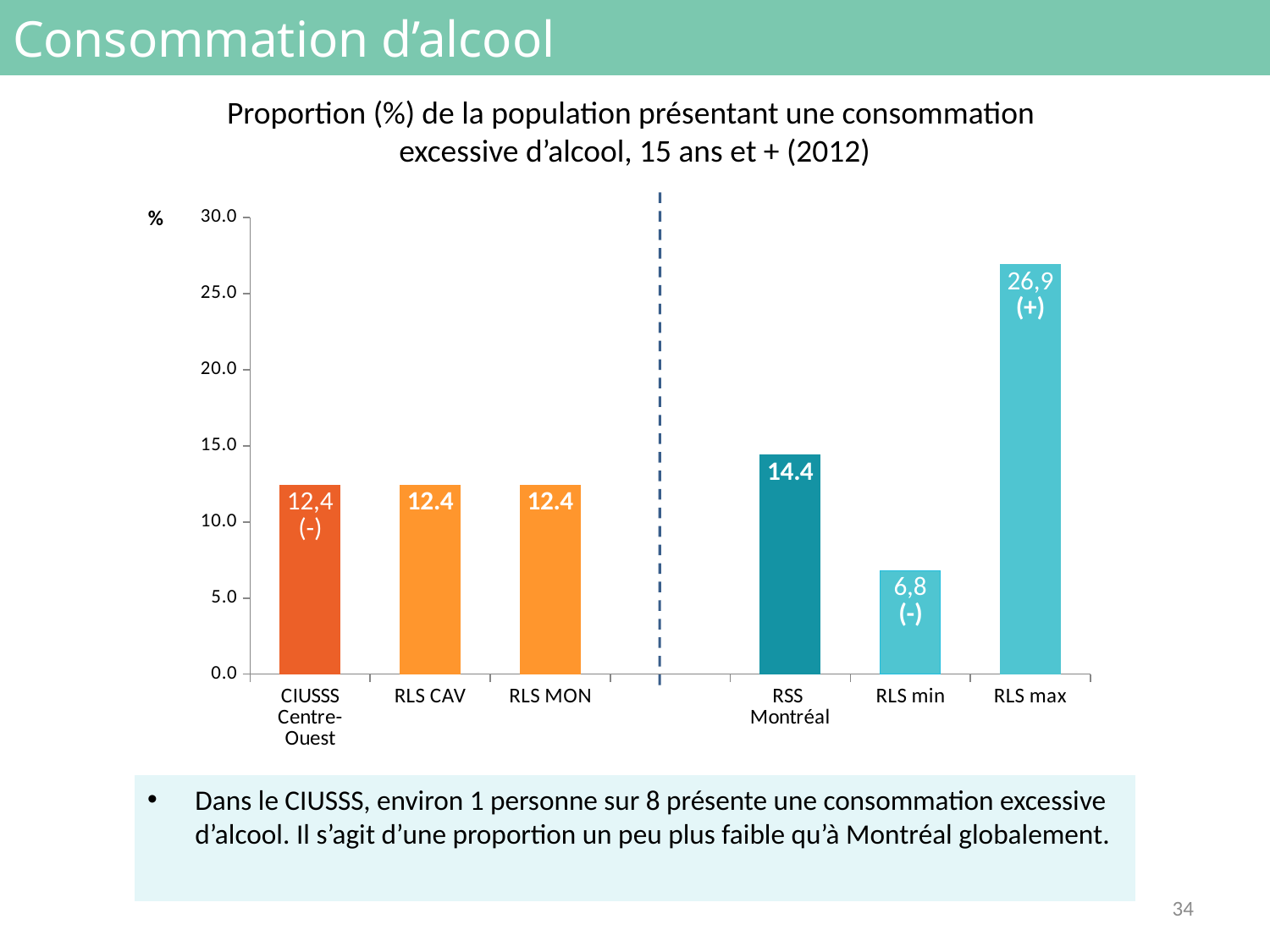
Which category has the highest value? RLS max What is the value for RLS min? 6,8 Which is larger, the value for RSS Montréal or the value for RLS MON? RSS Montréal Is the value for RLS max greater or less than 25.0? greater What is the value for CIUSSS Centre-Ouest? 12,4 What is the value for RSS Montréal? 14.4 What is the difference between the values for RSS Montréal and RLS CAV? 2.0 What is the difference between the values for RLS max and RLS min? 20,1 Which category has the lowest value? RLS min What is the value for RLS CAV? 12.4 How many categories are shown on the x axis? 6 What is the value for RLS max? 26,9